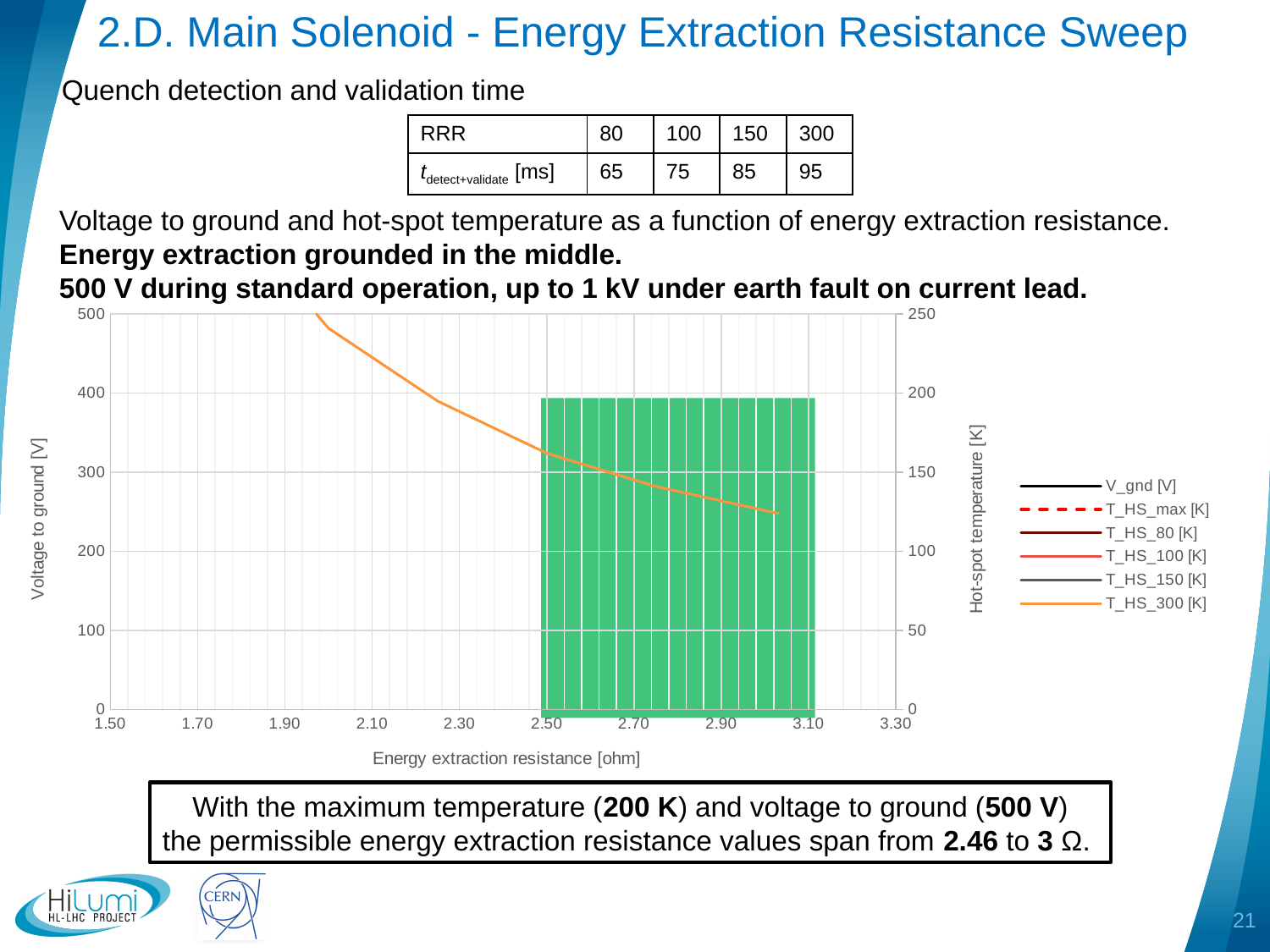
What is the label of the x axis of the chart? Energy extraction resistance [ohm] How many series does the chart legend list? 6 What is the maximum value shown on the left-hand y axis (Voltage to ground [V])? 500 What is the largest tick value shown on the x axis of the chart? 3.30 Is the hot-spot temperature of the T_HS_300 [K] line at 2.50 ohm greater or less than 150 K on the right axis? greater Is the hot-spot temperature of the T_HS_300 [K] line at 3.00 ohm greater or less than 150 K on the right axis? less What kind of chart is shown on the slide? line chart Does the orange T_HS_300 [K] line rise or fall as the energy extraction resistance increases? fall Is the T_HS_300 [K] line higher at 2.30 ohm or at 2.90 ohm? 2.30 ohm Is the hot-spot temperature of the T_HS_300 [K] line at 2.10 ohm greater or less than 200 K on the right axis? greater What is the label of the right-hand y axis of the chart? Hot-spot temperature [K] What is the maximum value shown on the right-hand y axis (Hot-spot temperature [K])? 250